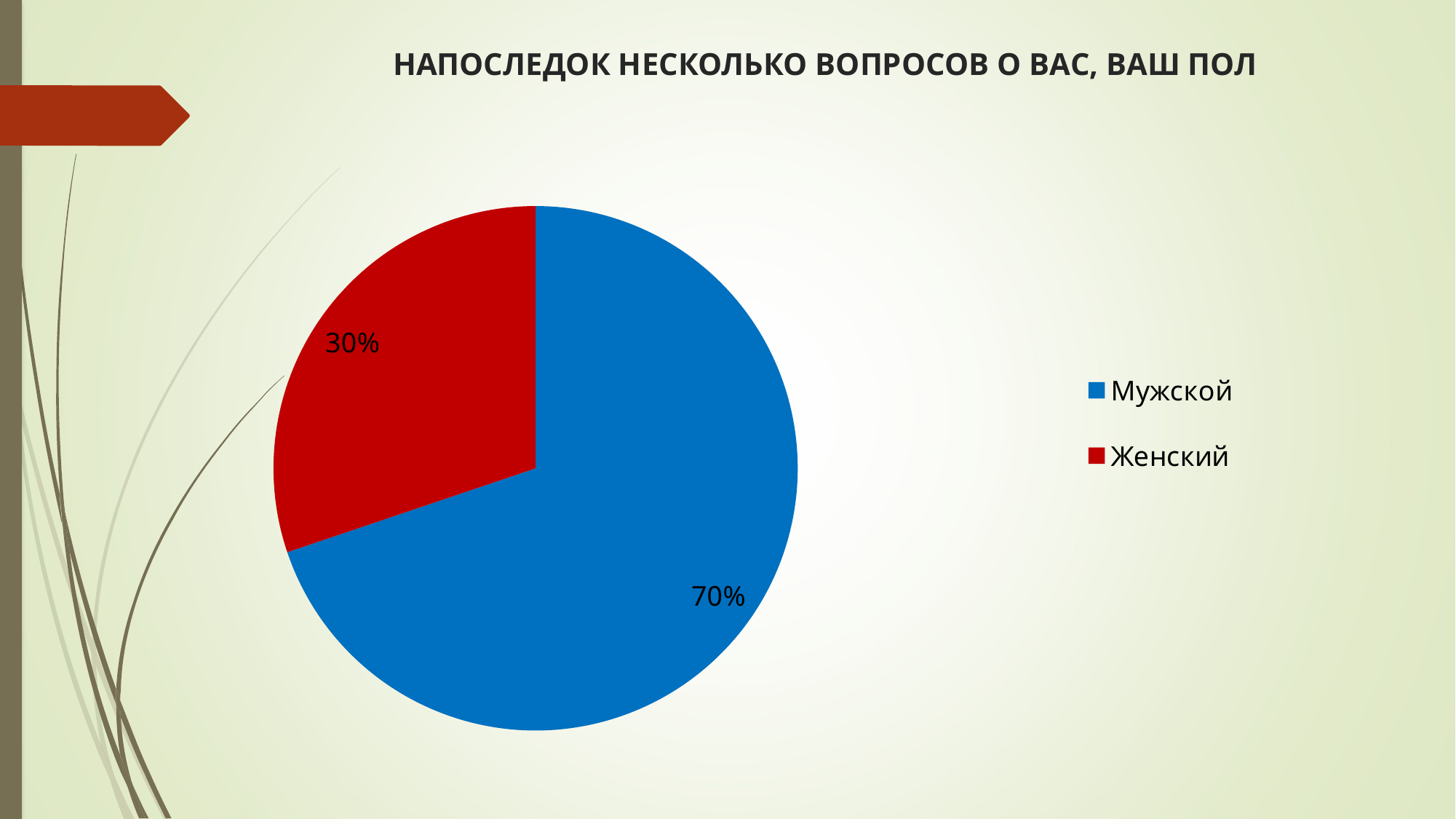
What is the title of the chart? НАПОСЛЕДОК НЕСКОЛЬКО ВОПРОСОВ О ВАС, ВАШ ПОЛ What share of the pie is Мужской? 70% How many entries does the legend list? 2 How many slices does the pie chart have? 2 What colour is the slice for Женский? red What kind of chart is shown on the slide? pie chart Which category has the smallest slice of the pie? Женский Which is larger, the share for Мужской or the share for Женский? Мужской What is the difference in percentage points between Мужской and Женский? 40% What share of the pie is Женский? 30% Which category has the largest slice of the pie? Мужской